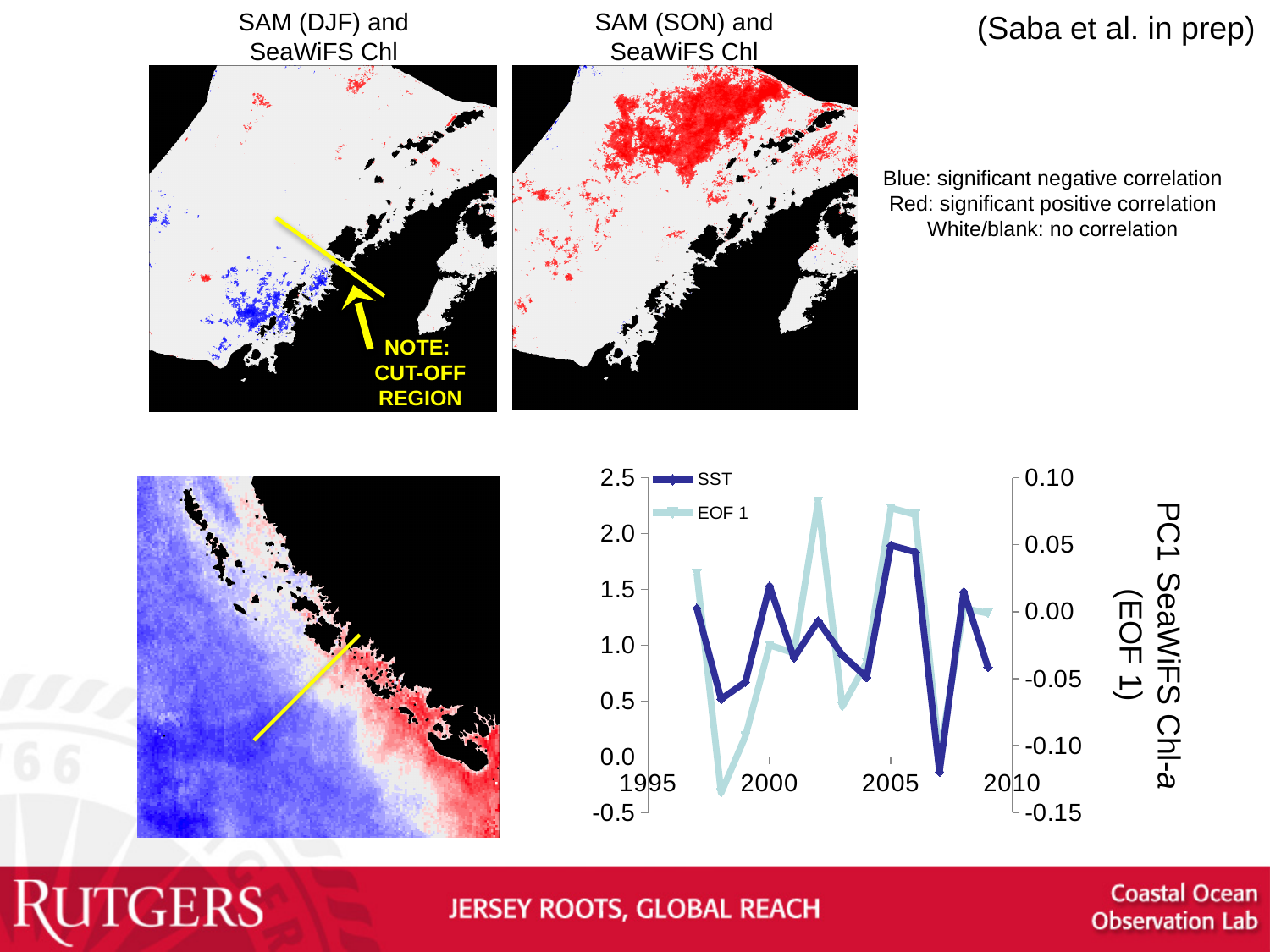
What are the two series named in the legend of the bottom-right line chart? SST and EOF 1 In the bottom-right line chart, is the SST value for 2007 greater or less than 0.0? less In the bottom-right line chart, is the SST value for 2005 greater or less than 1.5? greater In the bottom-right line chart, in which year is the EOF 1 series at its lowest? 1998 In the bottom-right line chart, in which year is the SST series at its lowest? 2007 In the bottom-right line chart, is the SST value for 1998 greater or less than 1.0? less What kind of chart is shown at the bottom right of the slide? line chart How many series does the legend of the bottom-right line chart list? 2 What is the title of the right-hand vertical axis of the bottom-right line chart? PC1 SeaWiFS Chl-a (EOF 1) In the bottom-right line chart, which is larger: the SST value for 2005 or the SST value for 2007? 2005